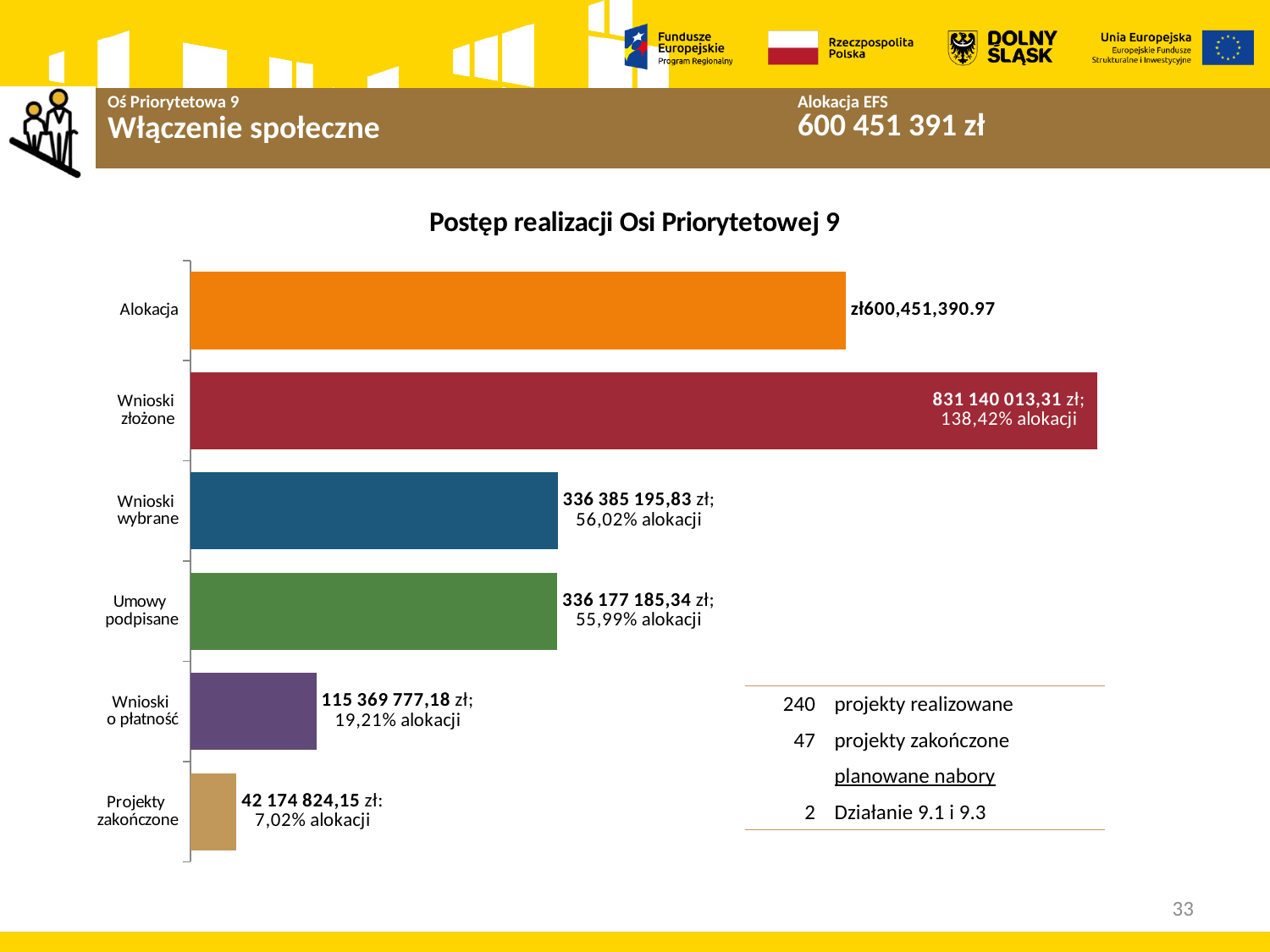
What percentage of the allocation do Wnioski wybrane represent? 56,02% How many categories (bars) does the chart show? 6 Which category has the lowest value? Projekty zakończone What is the difference between the values for Wnioski wybrane and Umowy podpisane? 208 010,49 zł What is the title of the chart? Postęp realizacji Osi Priorytetowej 9 What type of chart is shown on the slide? bar chart What is the value shown for Umowy podpisane? 336 177 185,34 zł What percentage of the allocation do Wnioski o płatność represent? 19,21% Which category has the highest value? Wnioski złożone What is the value shown for Wnioski złożone? 831 140 013,31 zł What is the value shown for Projekty zakończone? 42 174 824,15 zł Which is larger, the value for Wnioski złożone or the value for Alokacja? Wnioski złożone